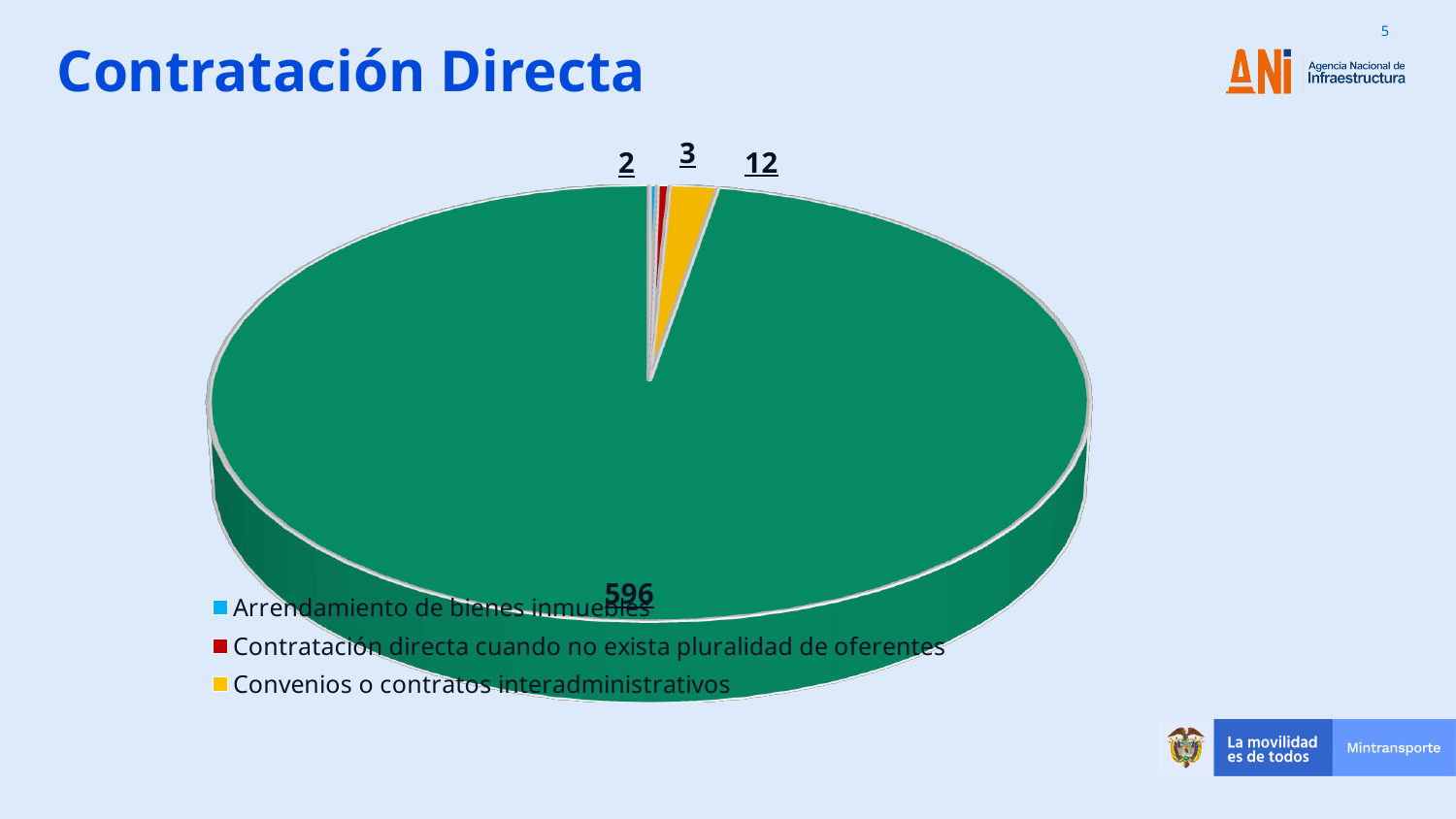
What is the difference between the value for Convenios o contratos interadministrativos and the value for Contratación directa cuando no exista pluralidad de oferentes? 9 What is the value for Arrendamiento de bienes inmuebles? 2 Which of the categories listed in the legend has the smallest value? Arrendamiento de bienes inmuebles What is the value for Contratación directa cuando no exista pluralidad de oferentes? 3 What is the value of the largest slice in the pie chart? 596 Which is larger: the value for Convenios o contratos interadministrativos or the value for Arrendamiento de bienes inmuebles? Convenios o contratos interadministrativos How many entries does the legend list? 3 What is the total of all the values shown on the pie chart? 613 How many slices does the pie chart have? 4 What is the title of the slide containing the pie chart? Contratación Directa What kind of chart is shown on the slide? Pie chart What is the value for Convenios o contratos interadministrativos? 12